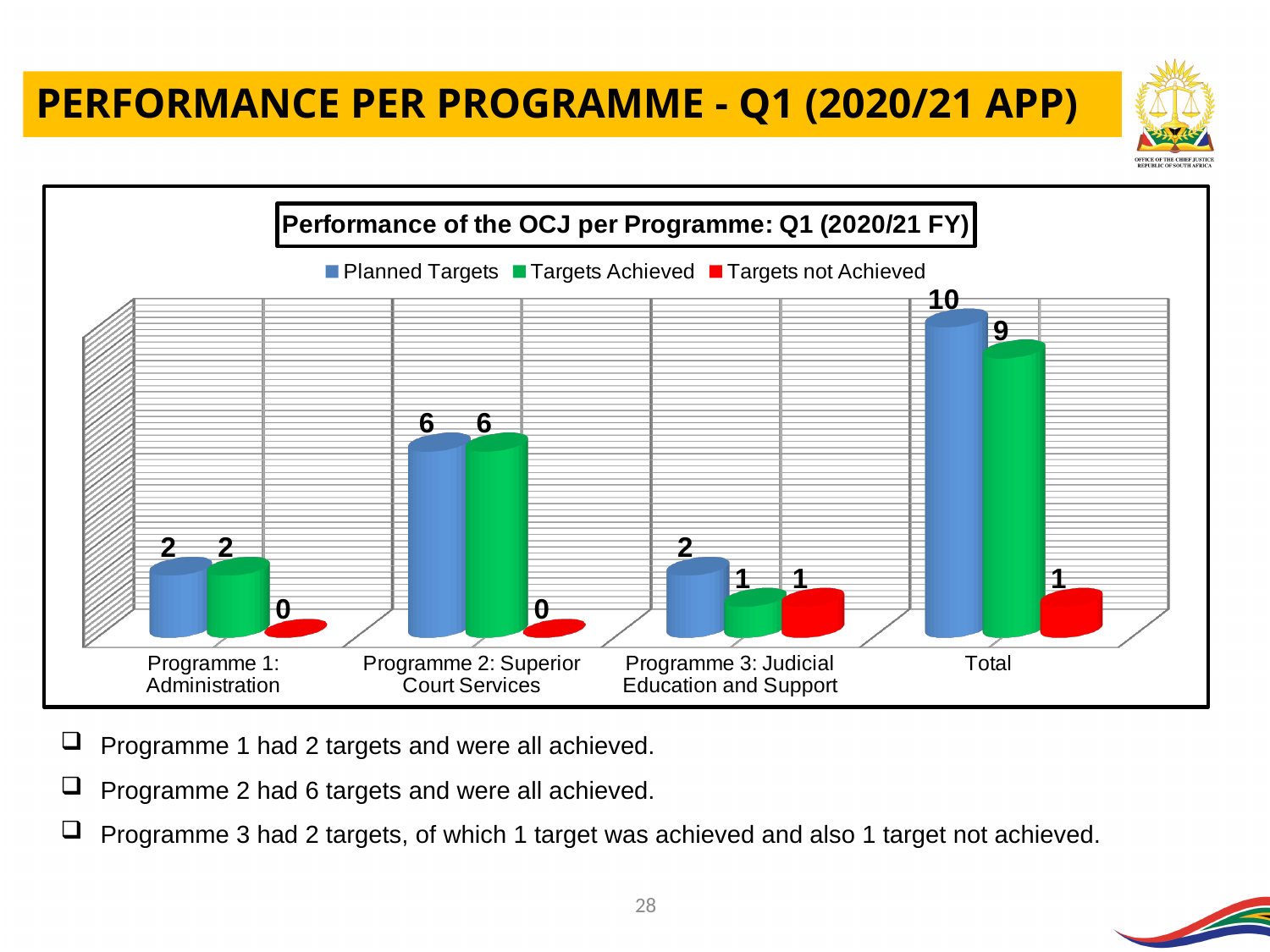
How many series does the legend list? 3 What is the difference between Planned Targets and Targets Achieved for Total? 1 What kind of chart is shown? Bar chart What is the value of Planned Targets for Programme 2: Superior Court Services? 6 How many categories are shown on the x axis? 4 Which is larger for Programme 3: Judicial Education and Support, Planned Targets or Targets Achieved? Planned Targets What is the title of the chart? Performance of the OCJ per Programme: Q1 (2020/21 FY) What is the value of Targets not Achieved for Programme 3: Judicial Education and Support? 1 What is the value of Planned Targets for Programme 1: Administration? 2 Which category has the highest Planned Targets value? Total Which programme (excluding Total) has the lowest Targets Achieved value? Programme 3: Judicial Education and Support What is the value of Targets Achieved for Total? 9